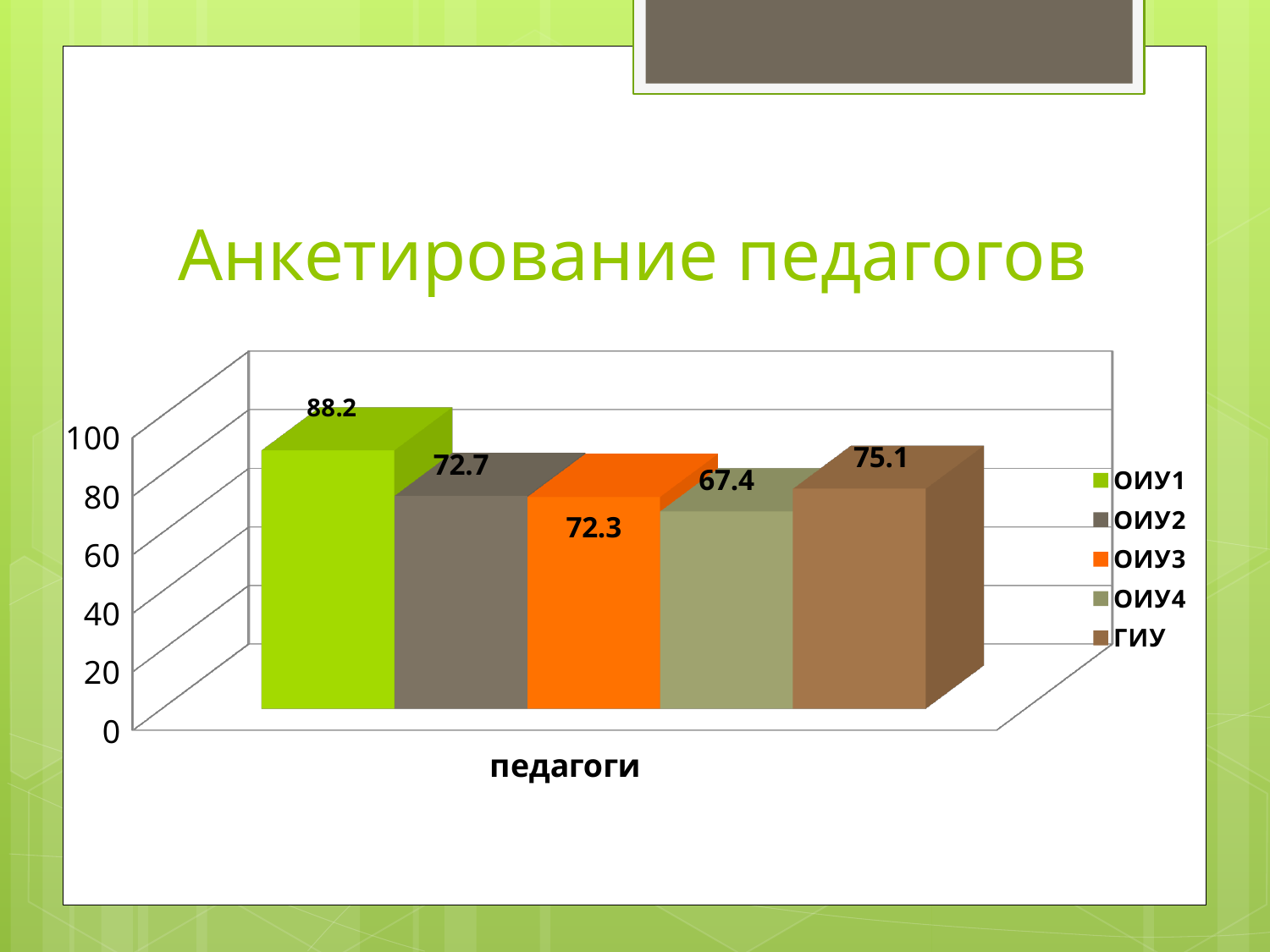
What is the value for ГИУ in the chart? 75.1 What is the value for ОИУ3 in the chart? 72.3 Which is larger, the value for ГИУ or the value for ОИУ2? ГИУ What is the value for ОИУ4 in the chart? 67.4 What is the title of the slide containing the chart? Анкетирование педагогов What is the difference between the values for ОИУ1 and ОИУ4? 20.8 How many series does the legend list? 5 What is the value for ОИУ1 in the chart? 88.2 What is the difference between the values for ГИУ and ОИУ4? 7.7 What kind of chart is shown on the slide? bar chart Which series has the lowest value in the chart? ОИУ4 Which series has the highest value in the chart? ОИУ1